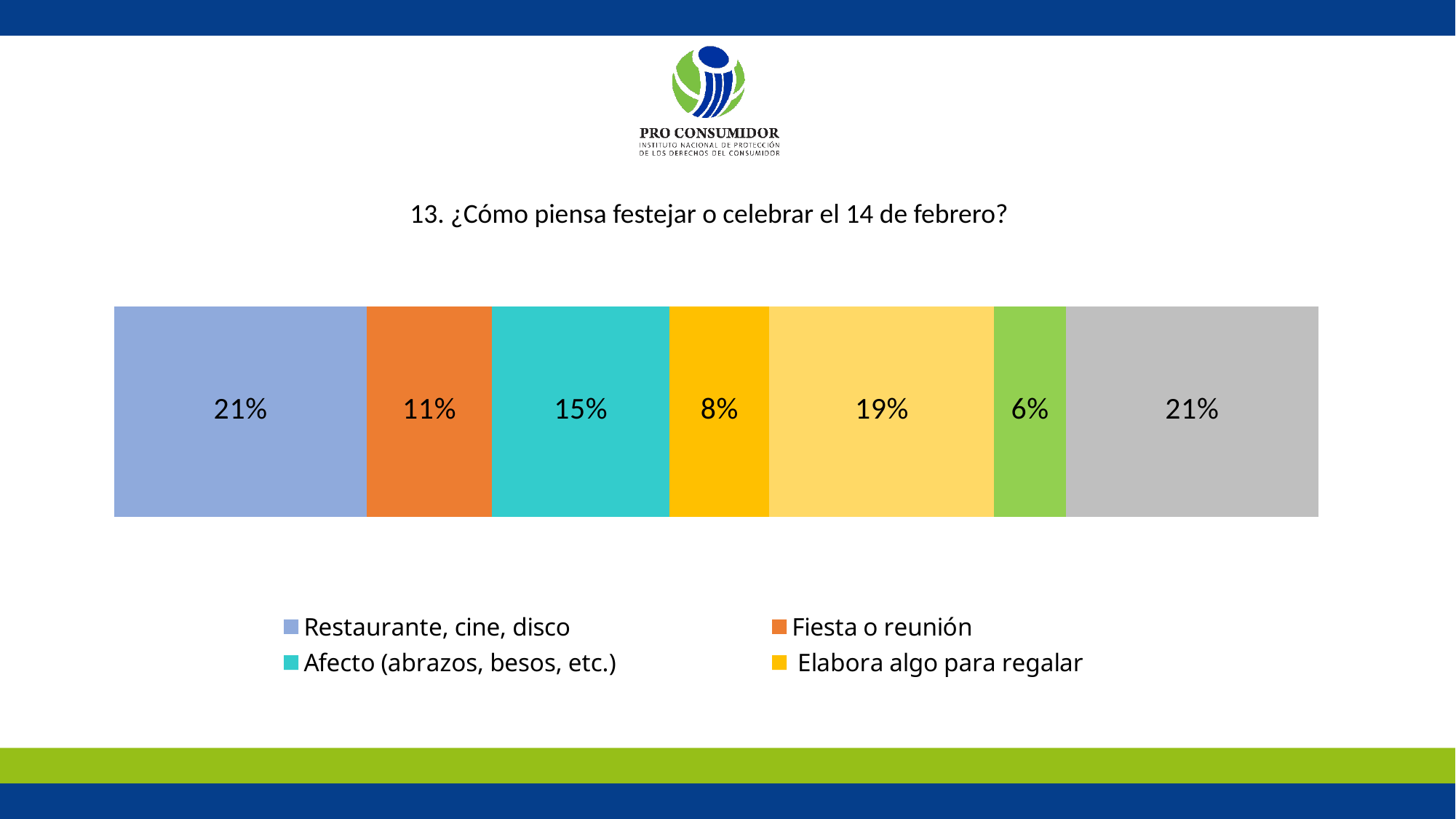
What percentage is shown for "Afecto (abrazos, besos, etc.)"? 15% How many entries does the legend list? 4 What percentage is shown for "Restaurante, cine, disco"? 21% Which has a larger share: "Fiesta o reunión" or "Afecto (abrazos, besos, etc.)"? Afecto (abrazos, besos, etc.) What is the smallest percentage shown on the bar? 6% What is the difference in percentage points between "Restaurante, cine, disco" and "Fiesta o reunión"? 10 What type of chart is shown on the slide? Stacked bar chart How many segments does the stacked bar contain? 7 What percentage is shown for "Elabora algo para regalar"? 8% What is the difference in percentage points between "Afecto (abrazos, besos, etc.)" and "Elabora algo para regalar"? 7 Which has a larger share: "Restaurante, cine, disco" or "Elabora algo para regalar"? Restaurante, cine, disco What percentage is shown for "Fiesta o reunión"? 11%